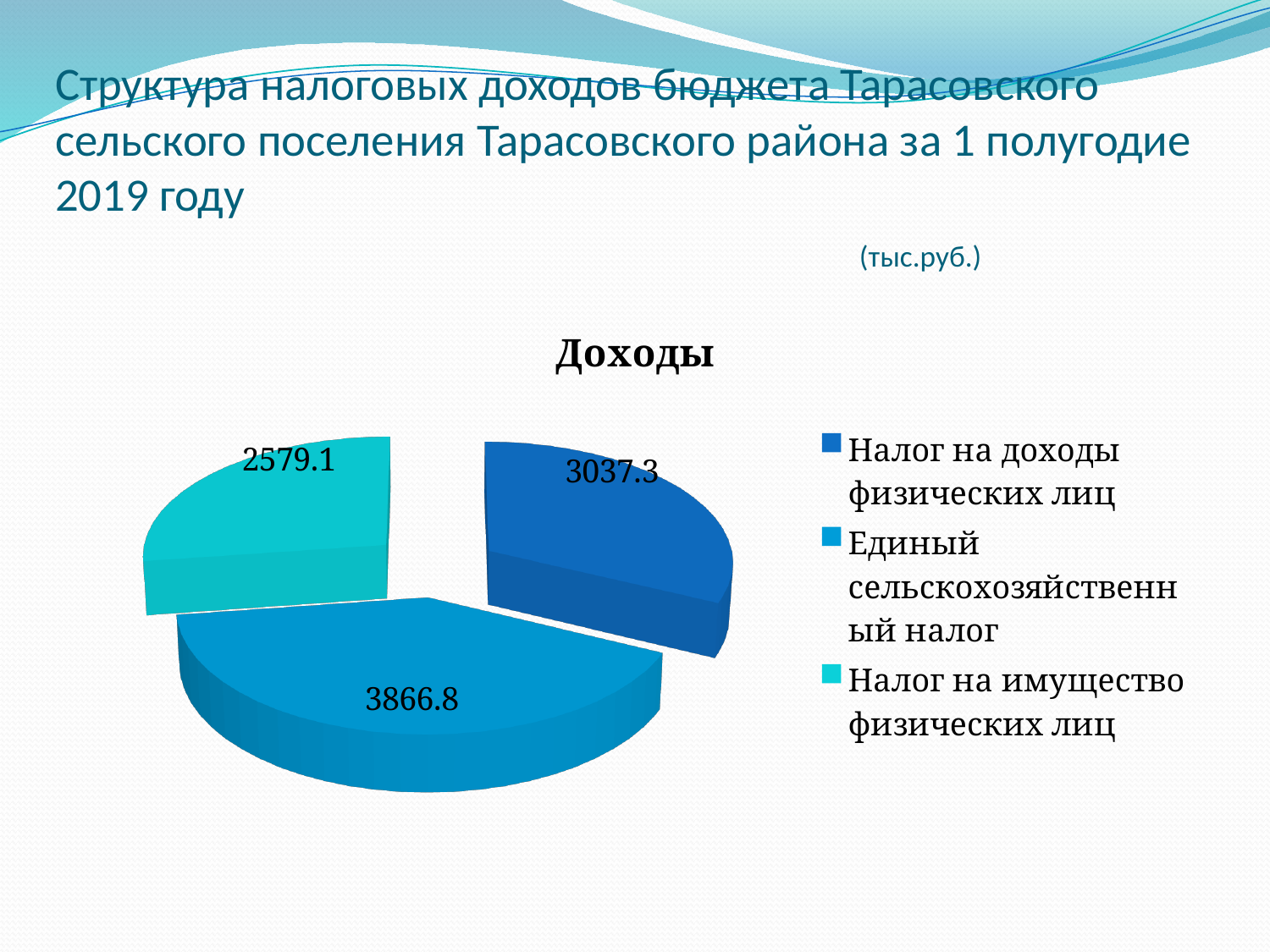
What is the value for Налог на доходы физических лиц? 3037.3 What is the title of the chart? Доходы How many categories does the pie chart show? 3 Which is larger: Налог на доходы физических лиц or Налог на имущество физических лиц? Налог на доходы физических лиц What is the value for Единый сельскохозяйственный налог? 3866.8 What is the difference between the values for Налог на доходы физических лиц and Налог на имущество физических лиц? 458.2 What share of the pie does Единый сельскохозяйственный налог represent, to the nearest whole percent? 41% What type of chart is shown on the slide? Pie chart Which category has the largest slice of the pie? Единый сельскохозяйственный налог Which category has the smallest slice of the pie? Налог на имущество физических лиц What is the value for Налог на имущество физических лиц? 2579.1 What is the difference between the values for Единый сельскохозяйственный налог and Налог на доходы физических лиц? 829.5